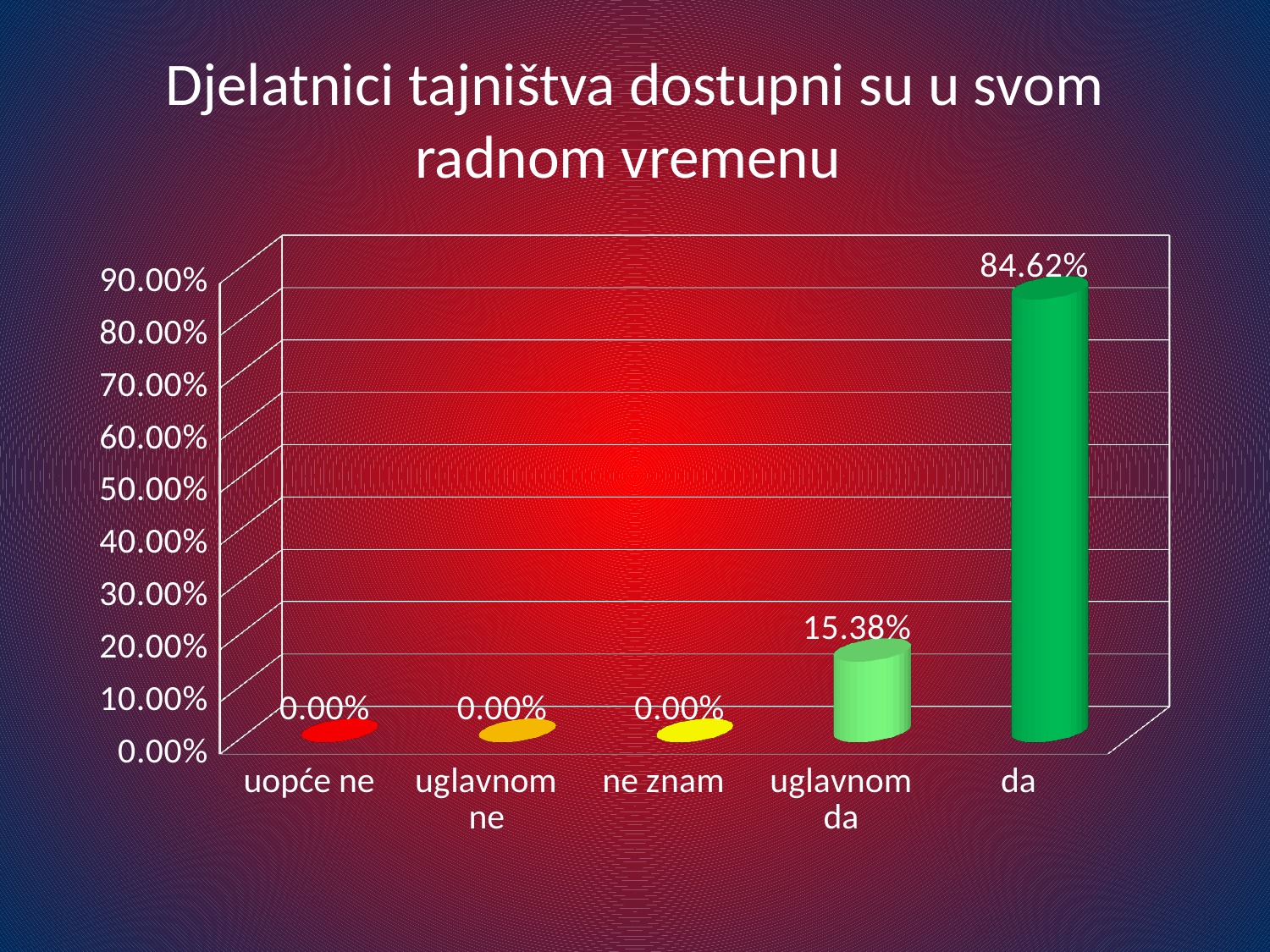
How many categories are shown on the x axis? 5 Is the value for "da" greater or less than 80.00%? greater Which category has the highest value? da How many categories have a value of 0.00%? 3 Which is larger, the value for "uglavnom da" or the value for "uglavnom ne"? uglavnom da What is the title of the chart? Djelatnici tajništva dostupni su u svom radnom vremenu What is the difference between the values for "da" and "uglavnom da"? 69.24% What is the value for "ne znam"? 0.00% What kind of chart is shown on the slide? bar chart What is the value for "da"? 84.62% Is the value for "uglavnom da" greater or less than 20.00%? less What is the value for "uglavnom da"? 15.38%